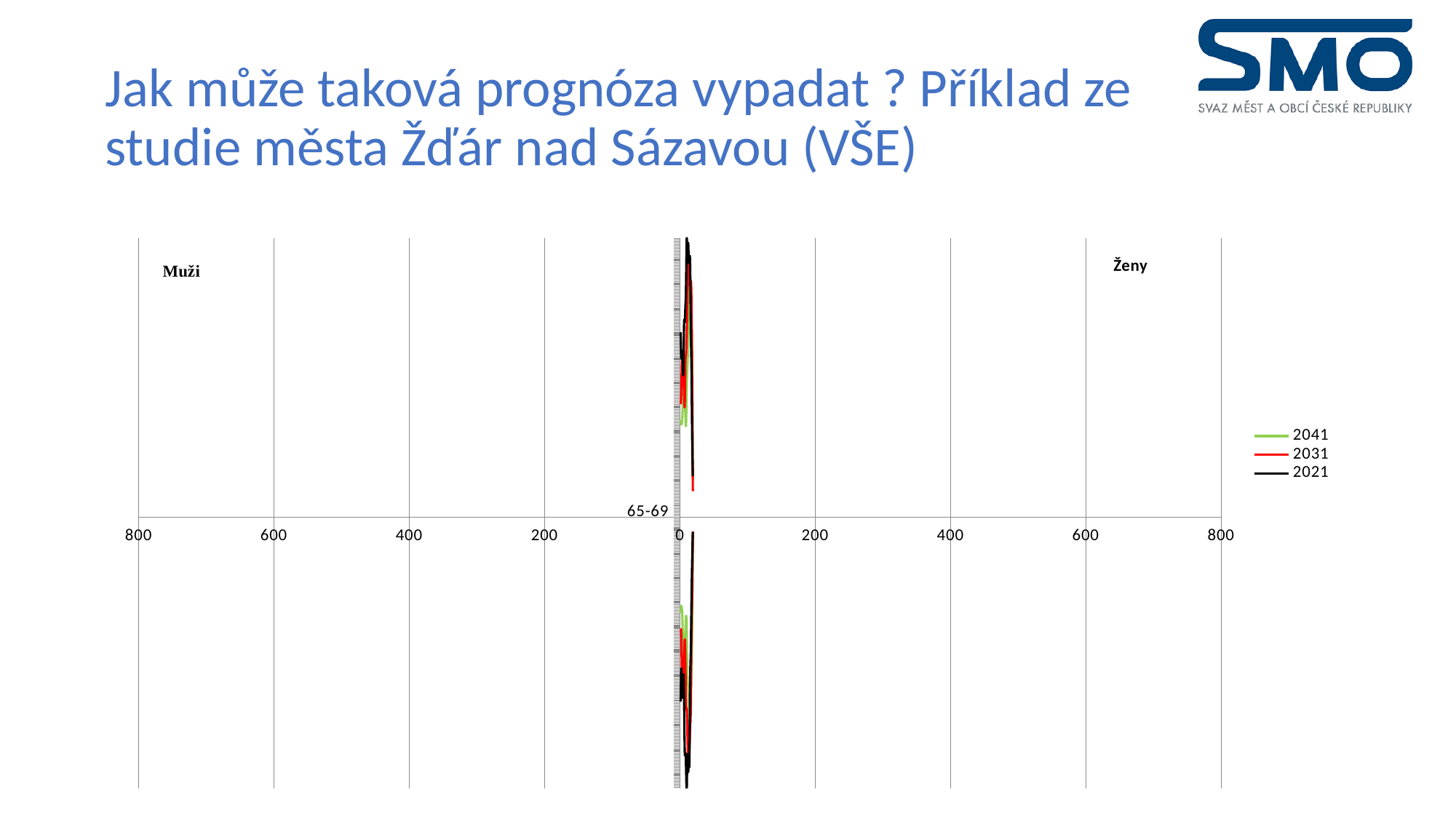
What label appears on the left side of the chart? Muži Which years are listed in the chart legend? 2041, 2031, 2021 What is the maximum value shown on the horizontal axis? 800 Is the 2031 value for the 65-69 age group on the Muži side greater or less than 200? less Is the 2021 value for the 65-69 age group on the Ženy side greater or less than 200? less How many series does the legend list? 3